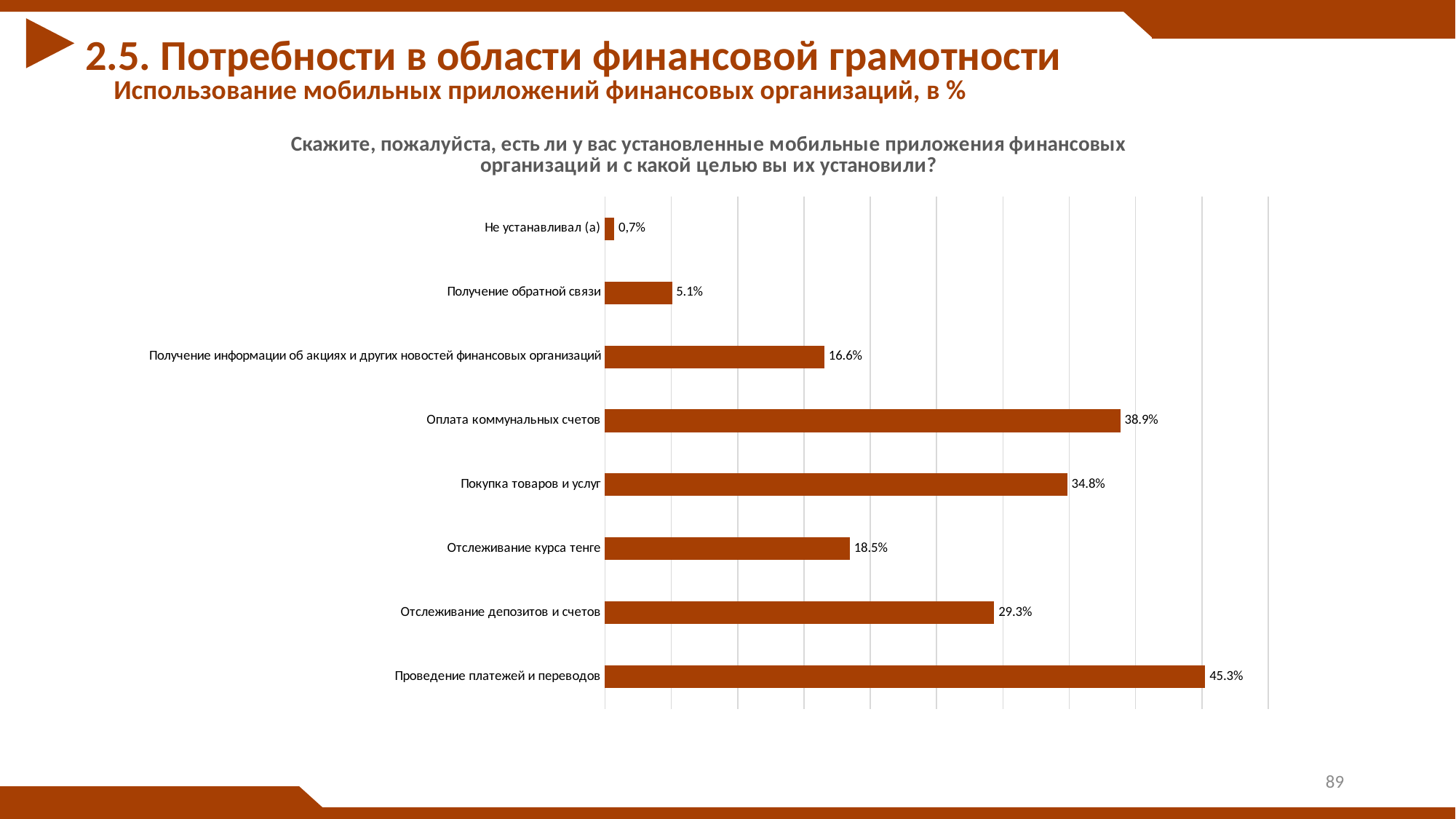
What kind of chart is shown on the slide? Bar chart What colour are the bars in the chart? Dark orange (brown-orange) What is the value for «Оплата коммунальных счетов»? 38.9% What is the value for «Не устанавливал (а)»? 0,7% Which category has the highest value? Проведение платежей и переводов What is the value for «Отслеживание курса тенге»? 18.5% What is the difference between «Отслеживание депозитов и счетов» and «Отслеживание курса тенге»? 10.8 percentage points What is the difference between «Проведение платежей и переводов» and «Оплата коммунальных счетов»? 6.4 percentage points How many categories are shown in the chart? 8 Which is larger: «Покупка товаров и услуг» or «Отслеживание депозитов и счетов»? Покупка товаров и услуг What is the value for «Проведение платежей и переводов»? 45.3% Which category has the lowest value? Не устанавливал (а)